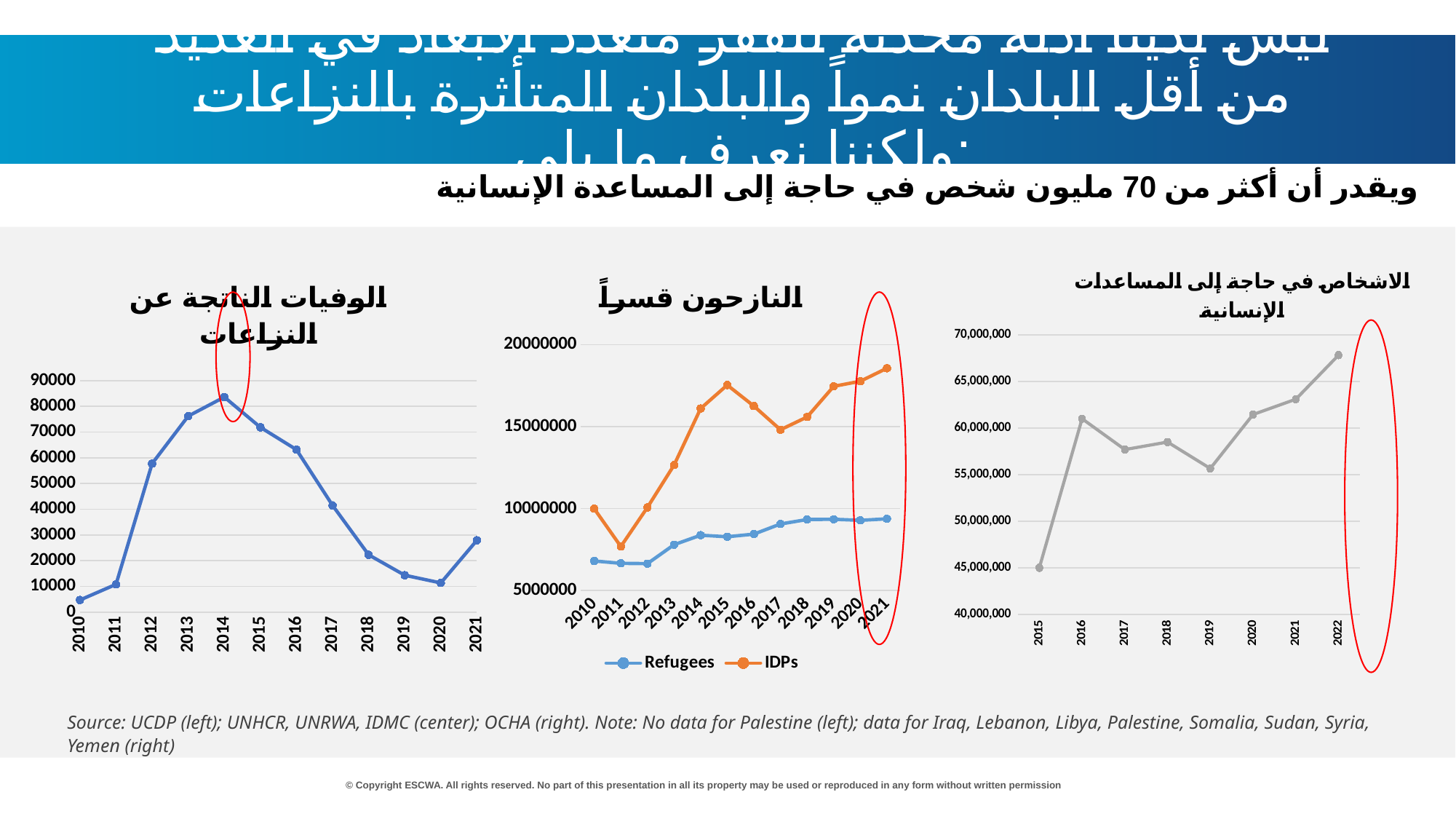
In the left chart, is the value for 2019 greater or less than 20000? less In the left chart, which year has the highest value? 2014 In the center chart, which series is higher in 2015, Refugees or IDPs? IDPs In the right chart, is the value for 2022 greater or less than 65,000,000? greater In the center chart, which year has the highest IDPs value? 2021 How many years are plotted on the x axis of the left chart? 12 How many series does the legend of the center chart list? 2 In the right chart, which year has the lowest value? 2015 In the left chart, is the value for 2014 greater or less than 80000? greater What kind of chart is the left chart on the slide? line chart In the left chart, which year has the lowest value? 2010